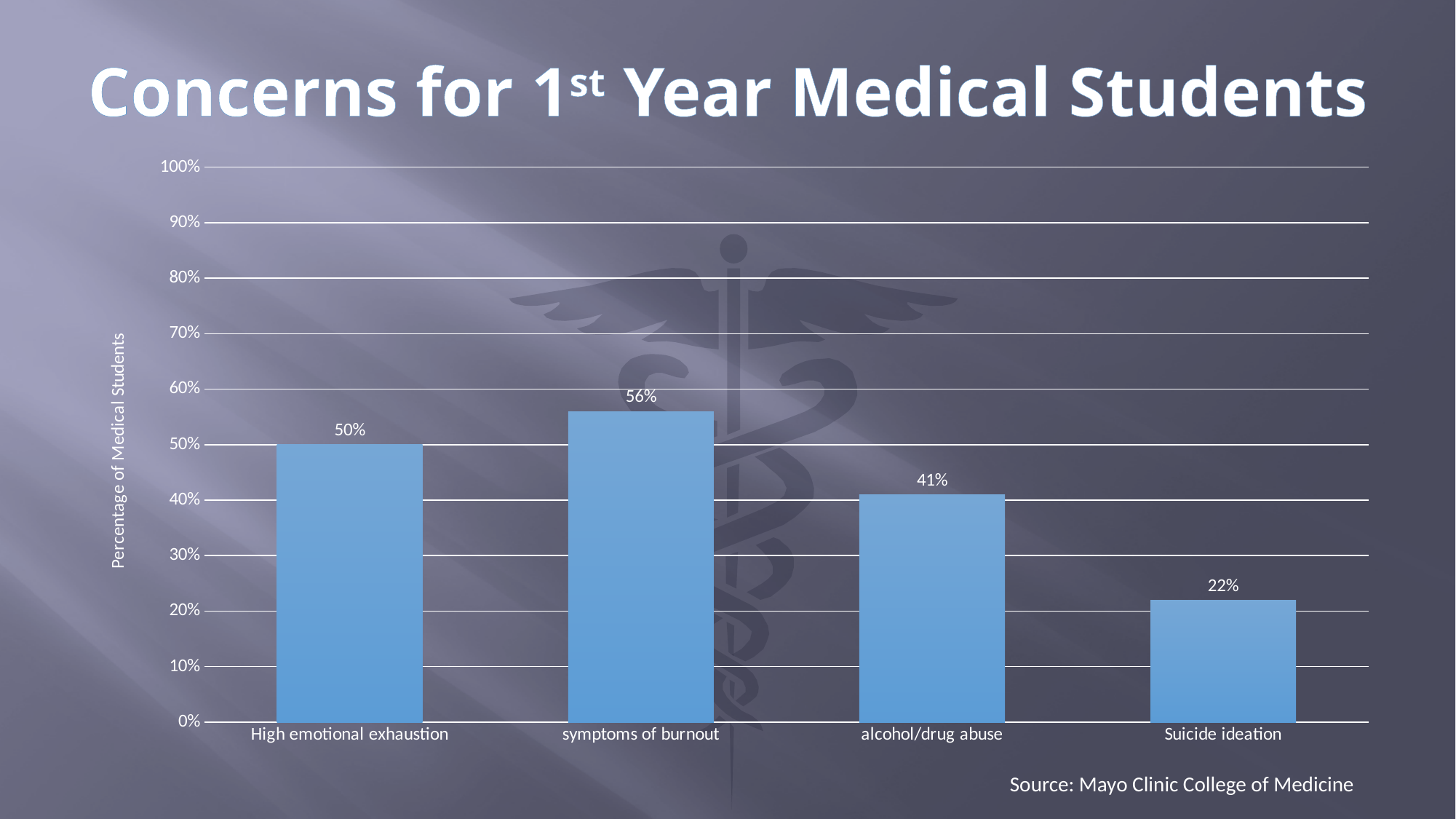
What percentage is shown for alcohol/drug abuse? 41% Which concern has the highest percentage? symptoms of burnout What percentage of medical students report high emotional exhaustion? 50% What is the value shown for symptoms of burnout? 56% Which is larger, the value for High emotional exhaustion or the value for alcohol/drug abuse? High emotional exhaustion What is the value for Suicide ideation? 22% Which concern has the lowest percentage? Suicide ideation What kind of chart is shown on the slide? bar chart What is the label of the vertical axis? Percentage of Medical Students Is the value for alcohol/drug abuse greater or less than 50%? less What is the difference between the percentages for symptoms of burnout and Suicide ideation? 34% How many categories are shown on the chart? 4